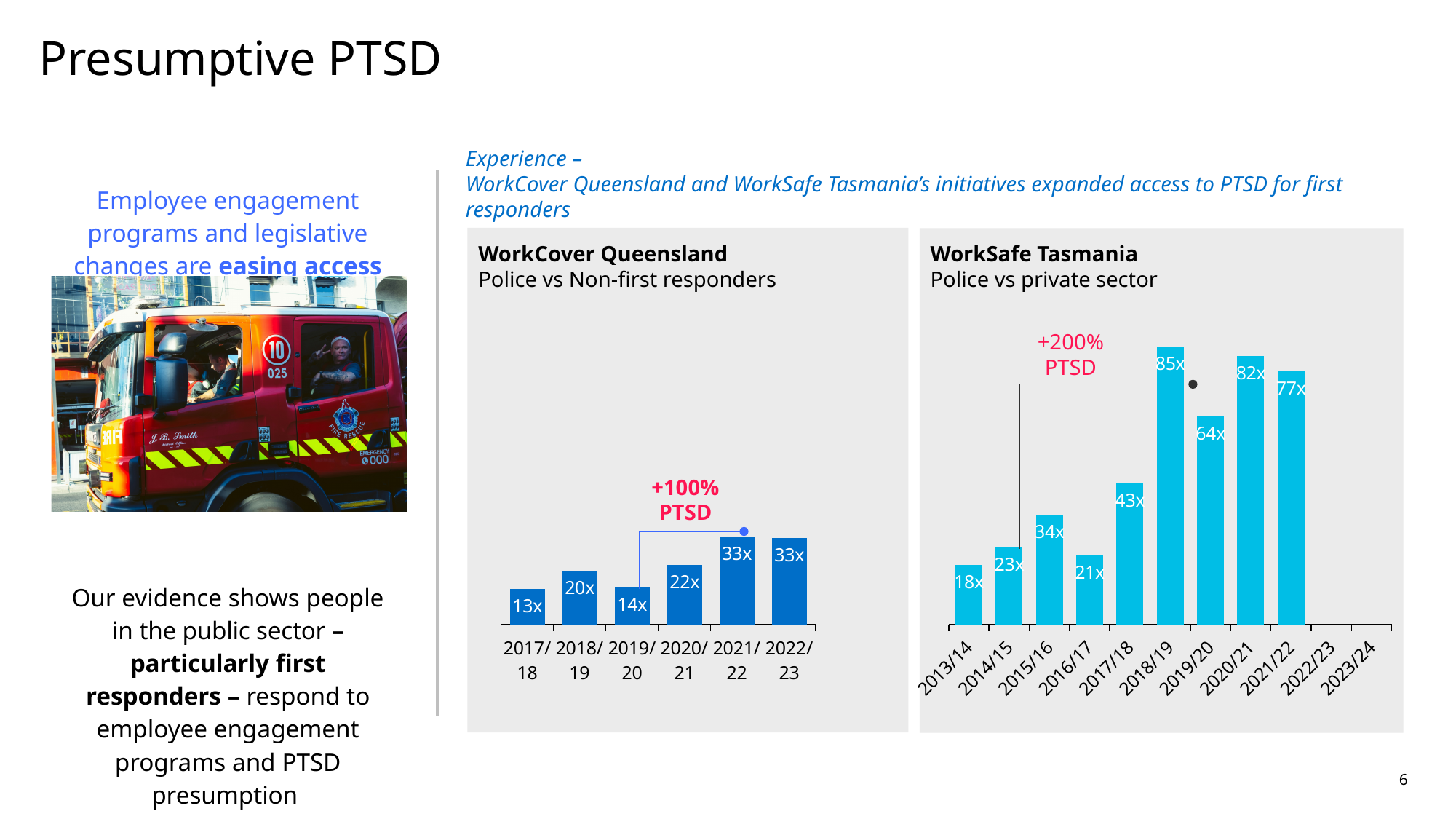
In the WorkSafe Tasmania chart, what is the value for 2017/18? 43x In the WorkSafe Tasmania chart, which year has the highest value? 2018/19 In the WorkCover Queensland chart, what is the difference between the values for 2021/22 and 2019/20? 19x In the WorkSafe Tasmania chart, what is the difference between the values for 2018/19 and 2019/20? 21x In the WorkCover Queensland chart, how many years are plotted? 6 In the WorkSafe Tasmania chart, how many bars are plotted? 9 In the WorkSafe Tasmania chart, which is larger, the value for 2020/21 or the value for 2021/22? 2020/21 What type of chart is the WorkSafe Tasmania chart? Bar chart In the WorkSafe Tasmania chart, which year has the lowest value? 2013/14 In the WorkCover Queensland chart, which year has the lowest value? 2017/18 In the WorkCover Queensland chart, what percentage increase in PTSD is annotated? +100% In the WorkCover Queensland chart, what is the value for 2020/21? 22x